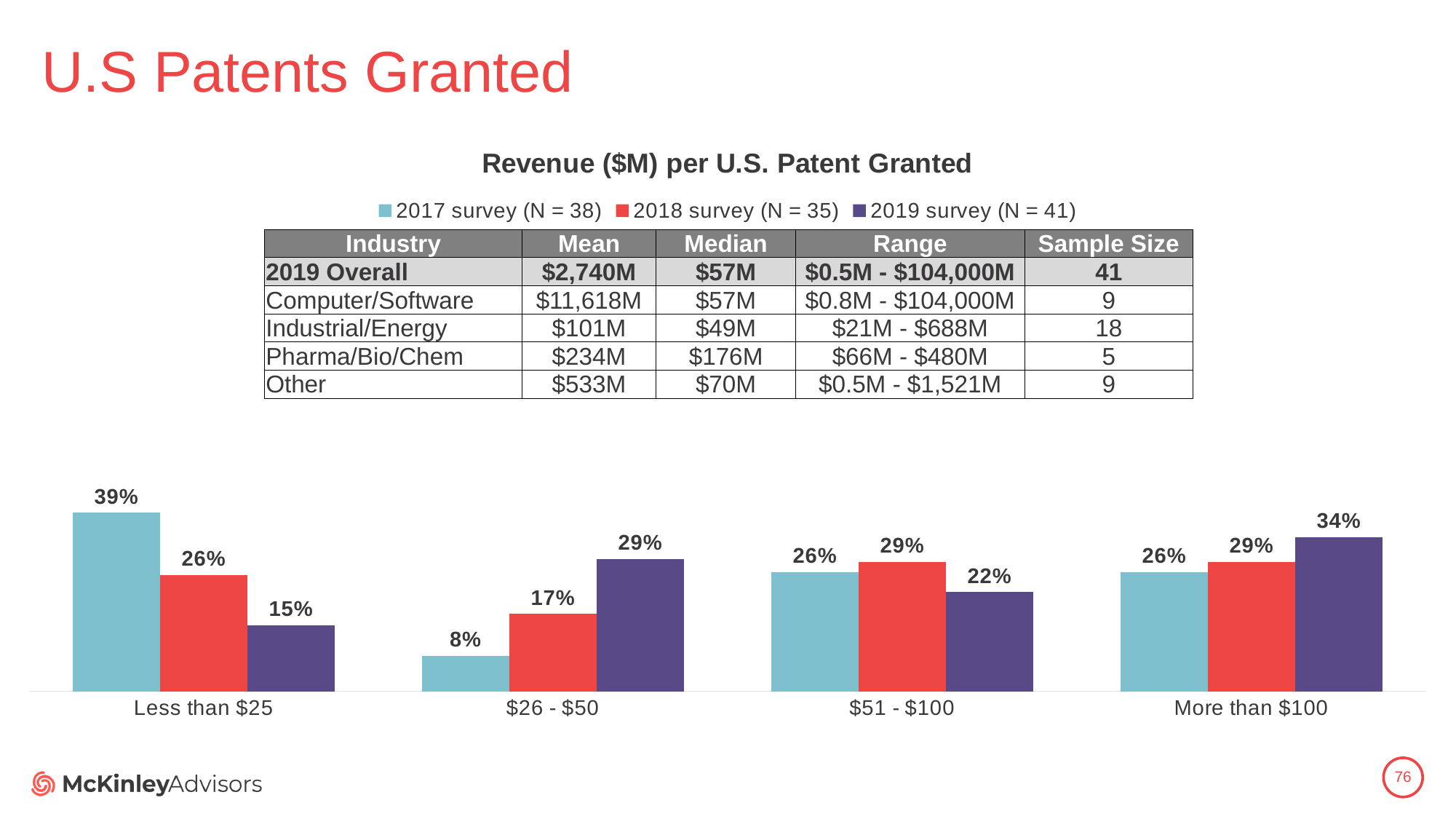
What is the difference between the 2019 survey and 2018 survey values in the "More than $100" category? 5 percentage points How many series does the chart legend list? 3 What type of chart is shown on the slide? Bar chart Which category has the highest value for the 2019 survey? More than $100 What is the value for the 2019 survey in the "Less than $25" category? 15% What is the difference between the 2017 survey and 2019 survey values in the "Less than $25" category? 24 percentage points What is the value for the 2017 survey in the "$26 - $50" category? 8% Which category has the lowest value for the 2019 survey? Less than $25 In the "$51 - $100" category, which is larger: the 2018 survey value or the 2019 survey value? 2018 survey Which category has the highest value for the 2017 survey? Less than $25 What is the value for the 2018 survey in the "More than $100" category? 29% How many categories are shown on the x axis of the chart? 4